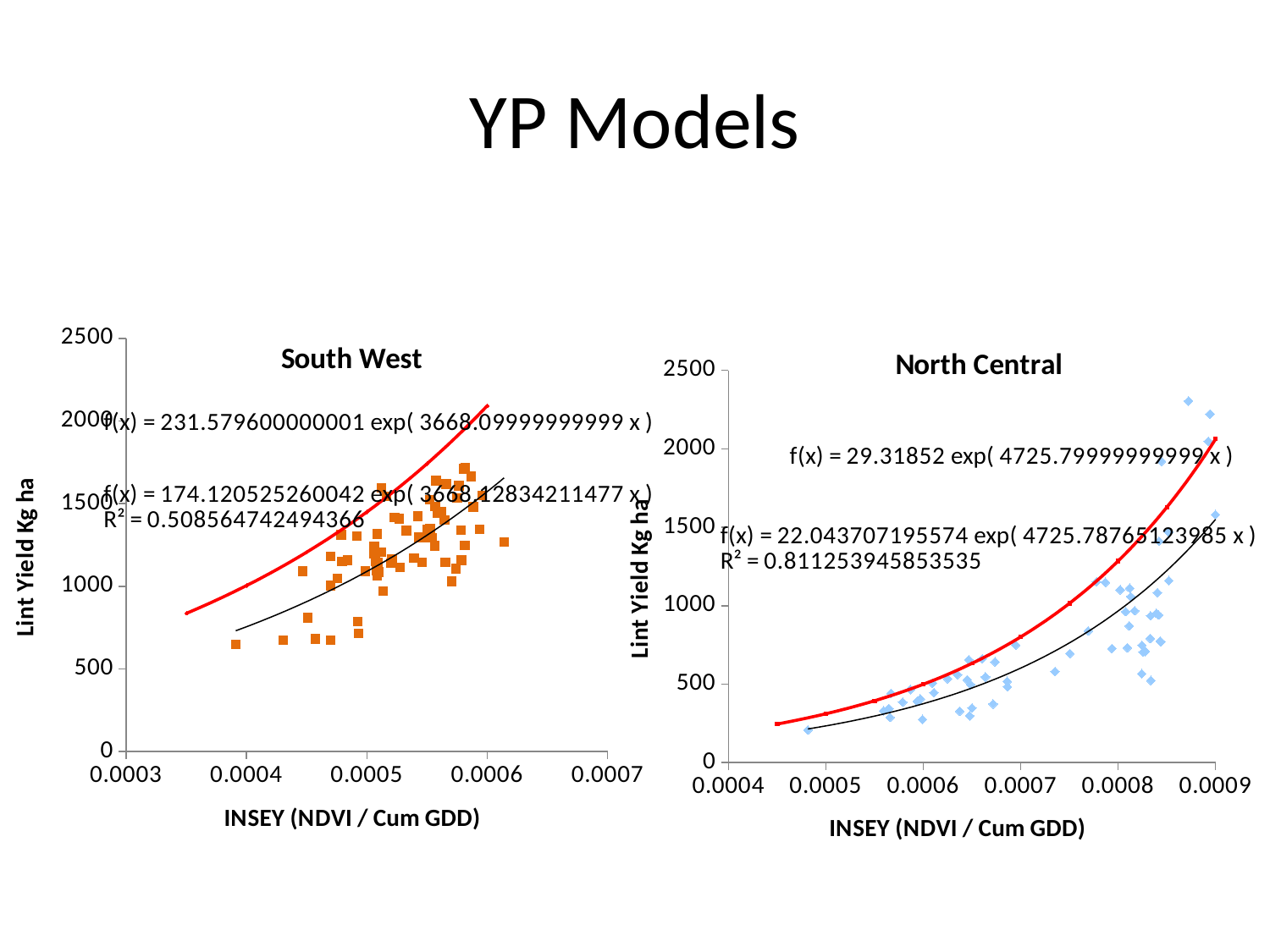
What is the x-axis label on the South West chart? INSEY (NDVI / Cum GDD) On the South West chart, is the highest plotted data point greater or less than 2000? less On the South West chart, do the lint yield values generally rise or fall as INSEY increases? rise On the North Central chart, is the highest plotted data point greater or less than 2000? greater Which chart shows the higher R² value, South West or North Central? North Central On the South West chart, what R² value is shown? 0.508564742494366 What is the title of the chart on the right side of the slide? North Central What kind of chart is the South West chart? scatter chart How many charts are shown on the slide? 2 On the North Central chart, what R² value is shown? 0.811253945853535 On the South West chart, is the lowest plotted data point greater or less than 1000? less On the North Central chart, do the lint yield values generally rise or fall as INSEY increases? rise